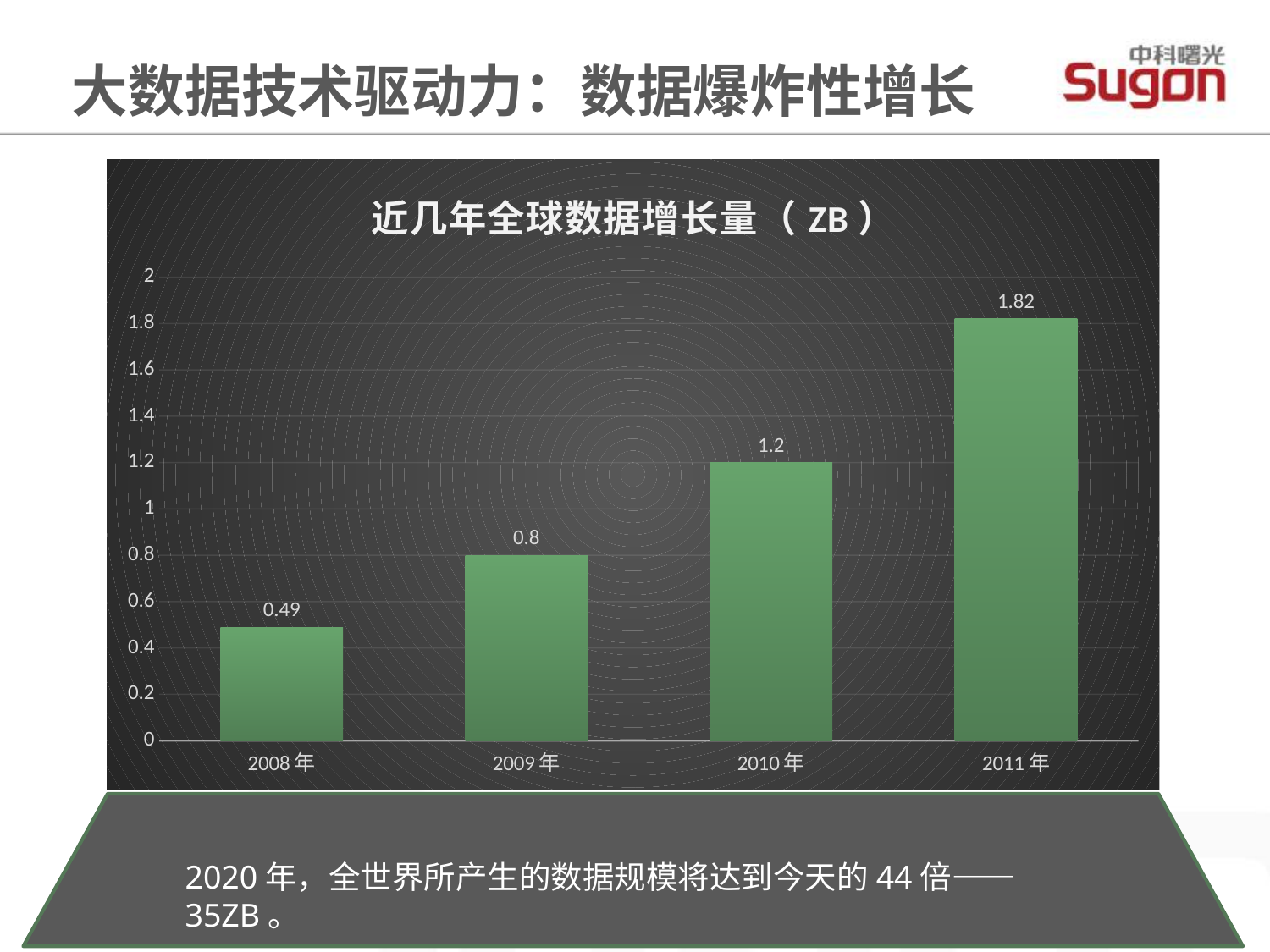
Which is larger, the value for 2010年 or the value for 2009年? 2010年 Which year has the lowest value? 2008年 What kind of chart is shown on the slide? bar chart What is the value for 2011年? 1.82 What is the value for 2009年? 0.8 What is the value for 2010年? 1.2 What is the value for 2008年? 0.49 How many years are shown on the x axis? 4 Which year has the highest value? 2011年 What is the difference between the values for 2009年 and 2008年? 0.31 Do the values rise or fall from 2008年 to 2011年? rise What is the difference between the values for 2011年 and 2010年? 0.62